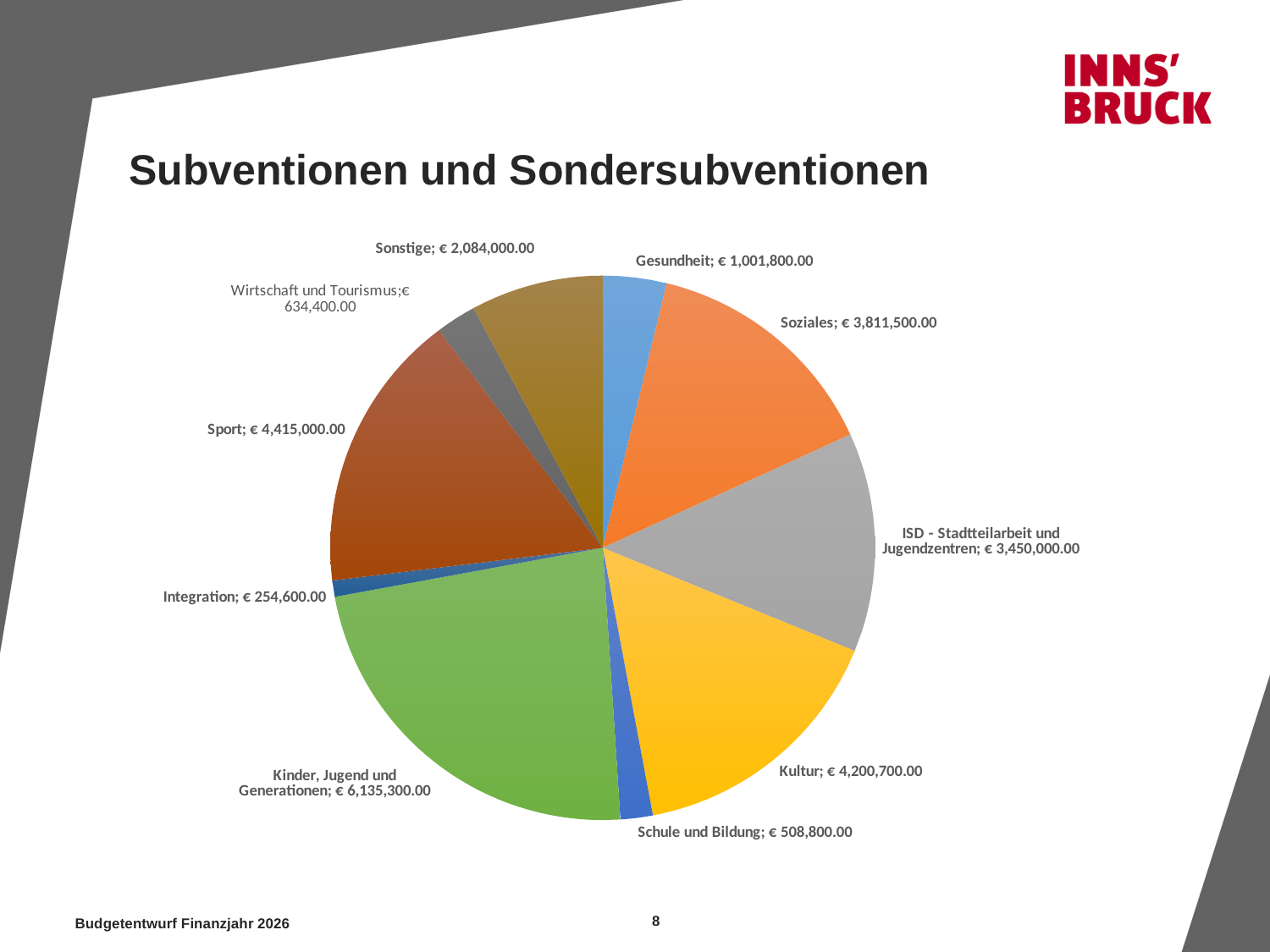
Which is larger, the value for Soziales or the value for ISD - Stadtteilarbeit und Jugendzentren? Soziales What is the title of the slide containing the chart? Subventionen und Sondersubventionen What is the difference between the values for Sport and Kultur? € 214,300.00 Which category has the smallest value? Integration What is the value for Wirtschaft und Tourismus? € 634,400.00 What is the value for Sport? € 4,415,000.00 What is the difference between the values for Kinder, Jugend und Generationen and Sport? € 1,720,300.00 What is the value for ISD - Stadtteilarbeit und Jugendzentren? € 3,450,000.00 What is the value for Schule und Bildung? € 508,800.00 What kind of chart is shown on the slide? Pie chart Which category has the largest value? Kinder, Jugend und Generationen How many categories are shown in the pie chart? 10